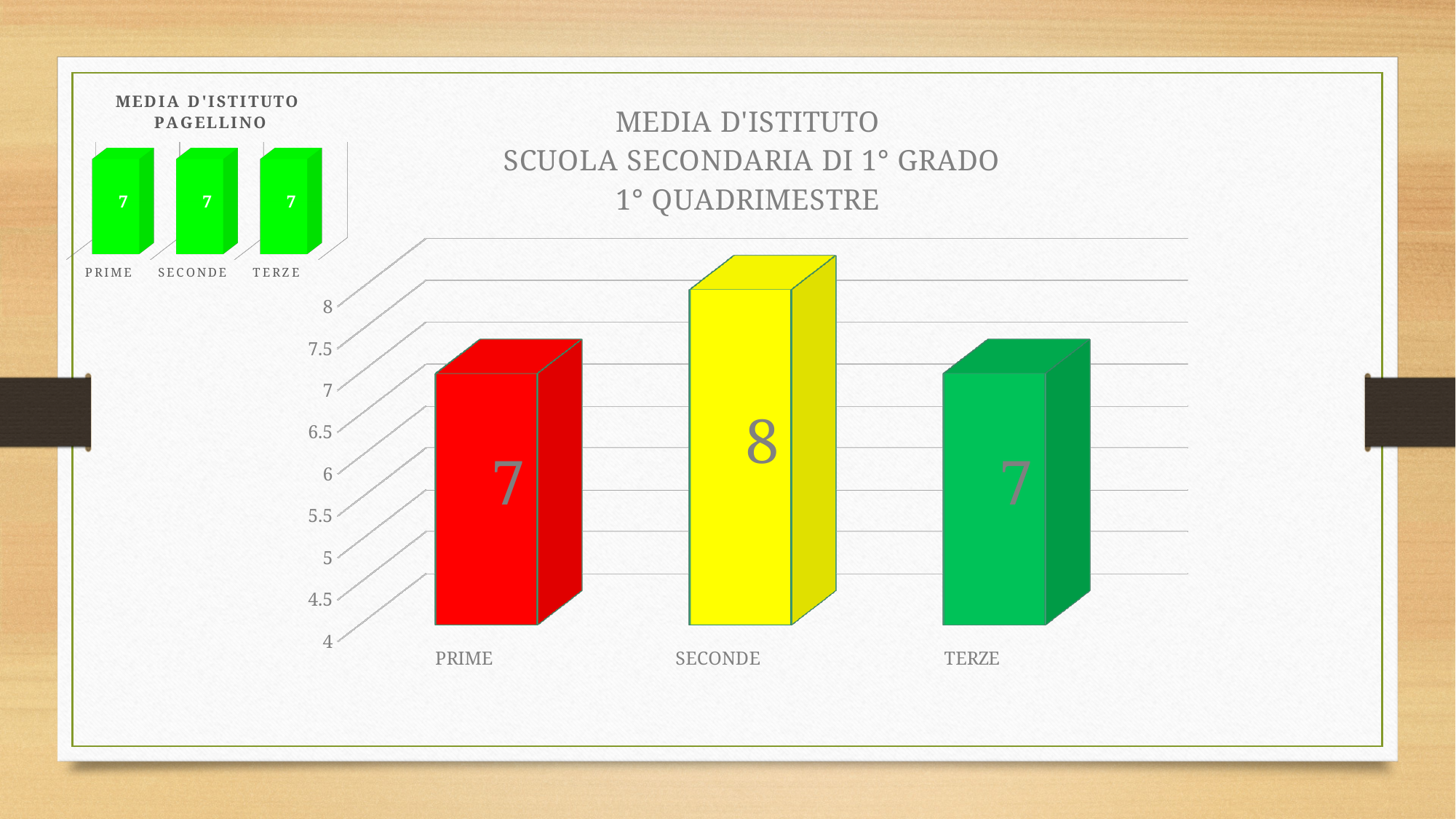
In the large chart titled "MEDIA D'ISTITUTO SCUOLA SECONDARIA DI 1° GRADO 1° QUADRIMESTRE", what colour is the bar for SECONDE? yellow In the small chart titled "MEDIA D'ISTITUTO PAGELLINO" at the top left, what is the value for TERZE? 7 In the large chart titled "MEDIA D'ISTITUTO SCUOLA SECONDARIA DI 1° GRADO 1° QUADRIMESTRE", what is the value for PRIME? 7 In the large chart titled "MEDIA D'ISTITUTO SCUOLA SECONDARIA DI 1° GRADO 1° QUADRIMESTRE", what is the value for SECONDE? 8 In the large chart titled "MEDIA D'ISTITUTO SCUOLA SECONDARIA DI 1° GRADO 1° QUADRIMESTRE", what is the difference between the values for SECONDE and PRIME? 1 In the small chart titled "MEDIA D'ISTITUTO PAGELLINO" at the top left, how many categories are shown? 3 In the large chart titled "MEDIA D'ISTITUTO SCUOLA SECONDARIA DI 1° GRADO 1° QUADRIMESTRE", how many categories are shown? 3 In the large chart titled "MEDIA D'ISTITUTO SCUOLA SECONDARIA DI 1° GRADO 1° QUADRIMESTRE", which is larger, the value for SECONDE or the value for TERZE? SECONDE In the large chart titled "MEDIA D'ISTITUTO SCUOLA SECONDARIA DI 1° GRADO 1° QUADRIMESTRE", what is the value for TERZE? 7 What kind of chart is the large chart titled "MEDIA D'ISTITUTO SCUOLA SECONDARIA DI 1° GRADO 1° QUADRIMESTRE"? bar chart In the large chart titled "MEDIA D'ISTITUTO SCUOLA SECONDARIA DI 1° GRADO 1° QUADRIMESTRE", which category has the highest value? SECONDE In the small chart titled "MEDIA D'ISTITUTO PAGELLINO" at the top left, what is the value for SECONDE? 7